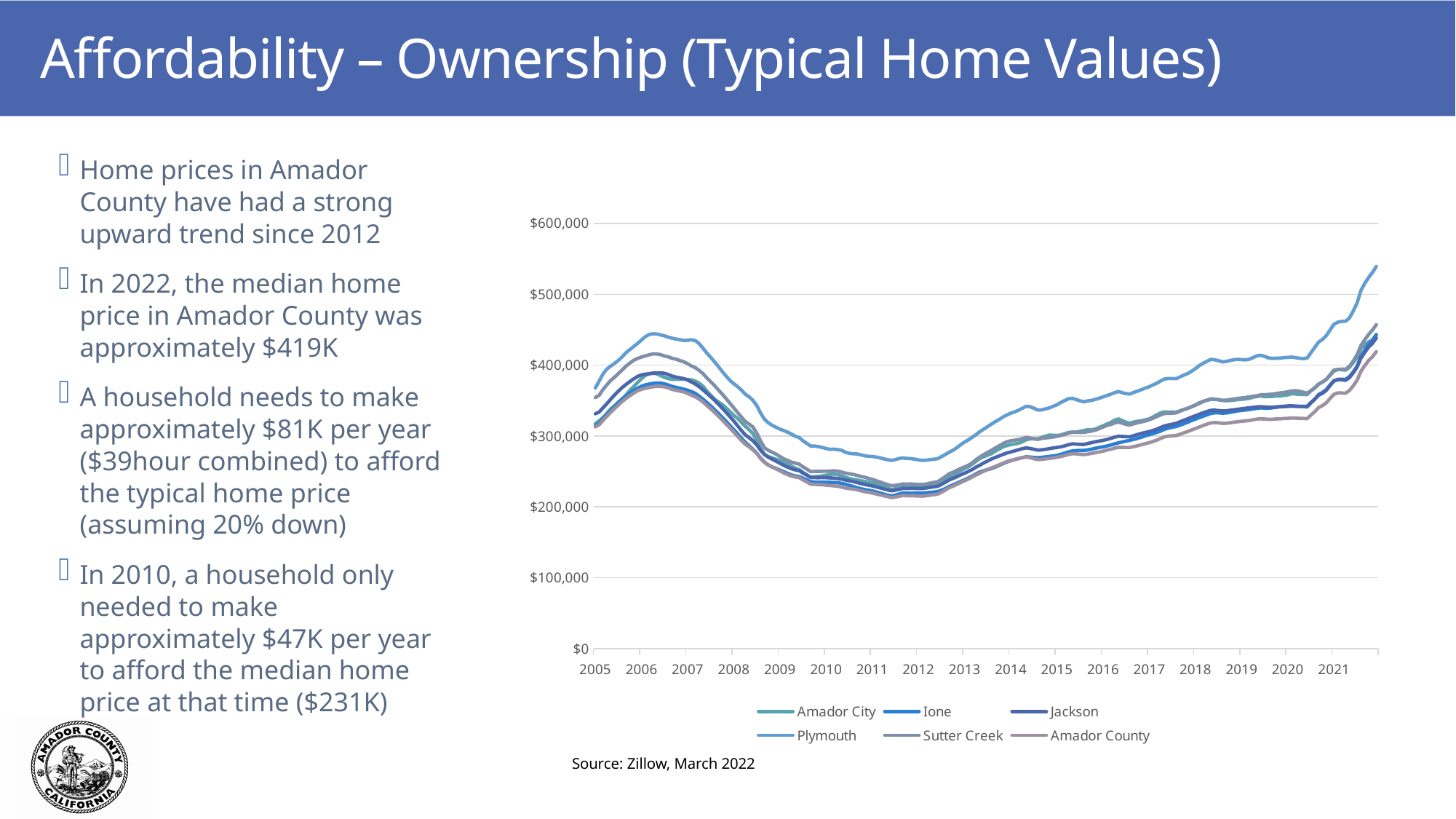
Is the value for Amador County in 2012 greater or less than $300,000? less Is the peak value for Plymouth around 2006 greater or less than $400,000? greater How many year labels are shown on the x axis? 17 Which series has the highest value at the end of the chart (late 2021)? Plymouth Is the value for Plymouth at the end of 2021 greater or less than $500,000? greater How many series does the chart legend list? 6 What kind of chart is shown on the slide? Line chart Do the home values rise or fall between 2006 and 2011? Fall What is the source cited below the chart? Zillow, March 2022 Do the home values rise or fall between 2012 and 2021? Rise